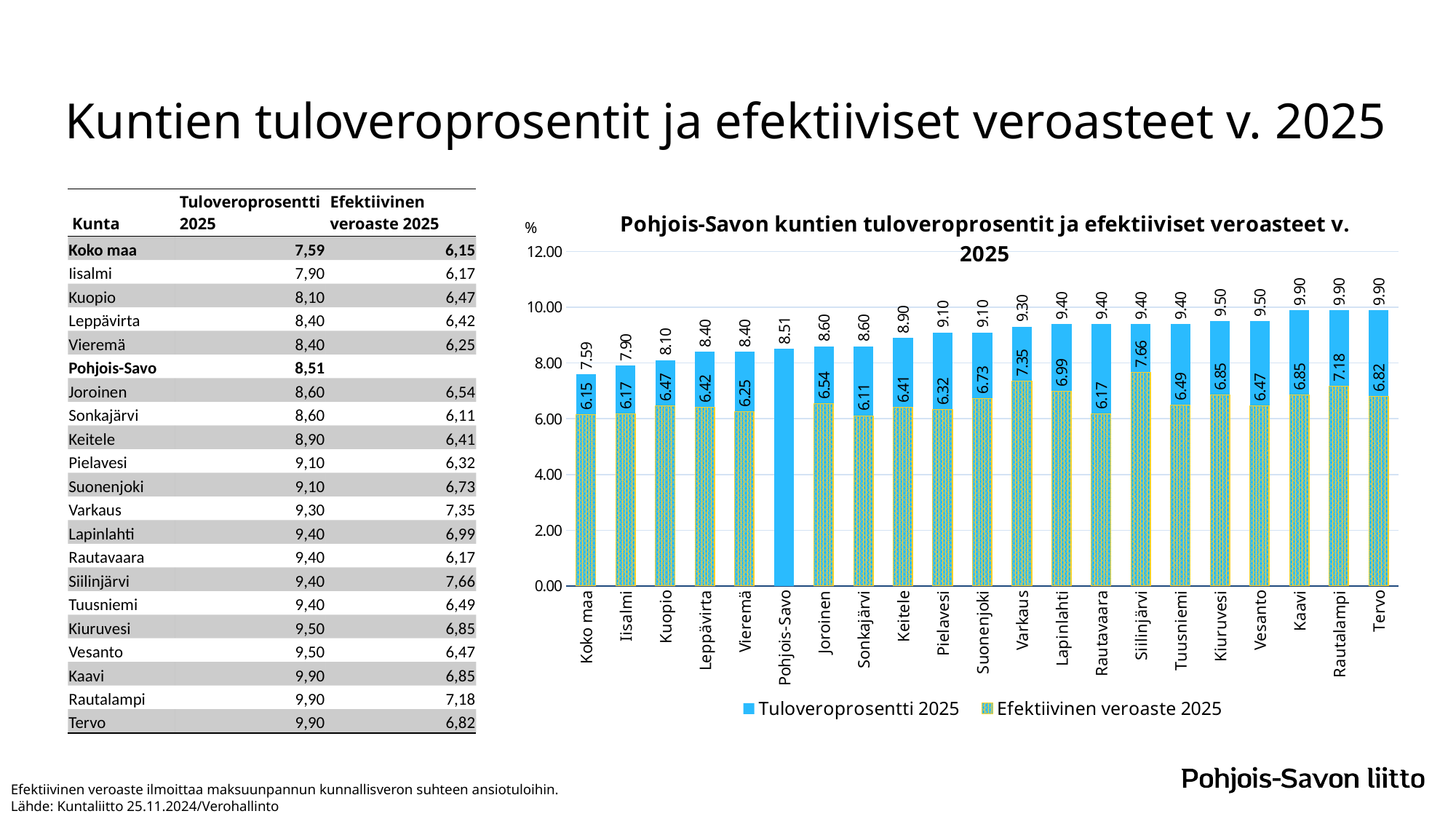
How many categories are shown on the x axis of the chart? 21 What is the Tuloveroprosentti 2025 value for Kuopio in the chart? 8.10 How many series does the chart legend list? 2 What is the Tuloveroprosentti 2025 value for Pohjois-Savo in the chart? 8.51 Which category has the lowest Tuloveroprosentti 2025 in the chart? Koko maa What is the Efektiivinen veroaste 2025 value for Varkaus in the chart? 7.35 Do the Tuloveroprosentti 2025 values generally rise or fall from left to right along the x axis? rise Which category has the highest Efektiivinen veroaste 2025 in the chart? Siilinjärvi Which has the larger Efektiivinen veroaste 2025, Siilinjärvi or Varkaus? Siilinjärvi Which category has the lowest Efektiivinen veroaste 2025 in the chart? Sonkajärvi What is the difference between the Tuloveroprosentti 2025 and the Efektiivinen veroaste 2025 for Varkaus? 1.95 Is the Tuloveroprosentti 2025 value for Koko maa greater or less than 8.00? less